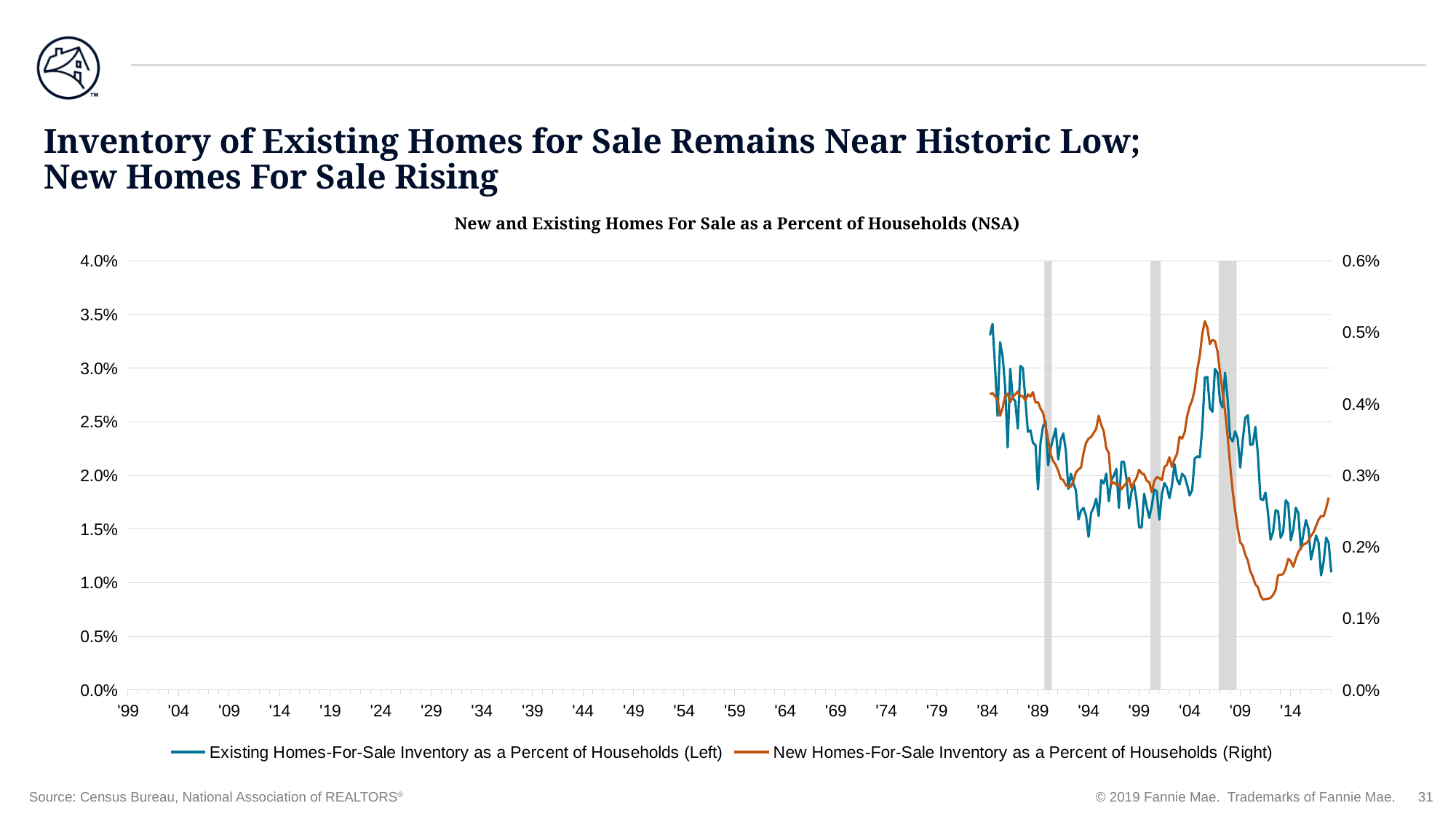
What kind of chart is shown on the slide? line chart How many series does the legend list? 2 What is the title of the chart? New and Existing Homes For Sale as a Percent of Households (NSA) Overall, does the Existing Homes-For-Sale Inventory series rise or fall from 1984 to the end of the chart? fall Is the lowest value of the New Homes-For-Sale Inventory series (around 2012) greater or less than 0.2% on the right axis? less Does the New Homes-For-Sale Inventory series rise or fall between about 2006 and 2012? fall Does the New Homes-For-Sale Inventory series rise or fall from about 2012 to the end of the chart? rise Is the value of the Existing Homes-For-Sale Inventory series at the start of the chart (around 1984) greater or less than 3.0%? greater What is the highest value shown on the left-hand axis? 4.0% Which series is plotted against the right-hand axis? New Homes-For-Sale Inventory as a Percent of Households Is the peak value of the New Homes-For-Sale Inventory series (around 2006) greater or less than 0.4% on the right axis? greater